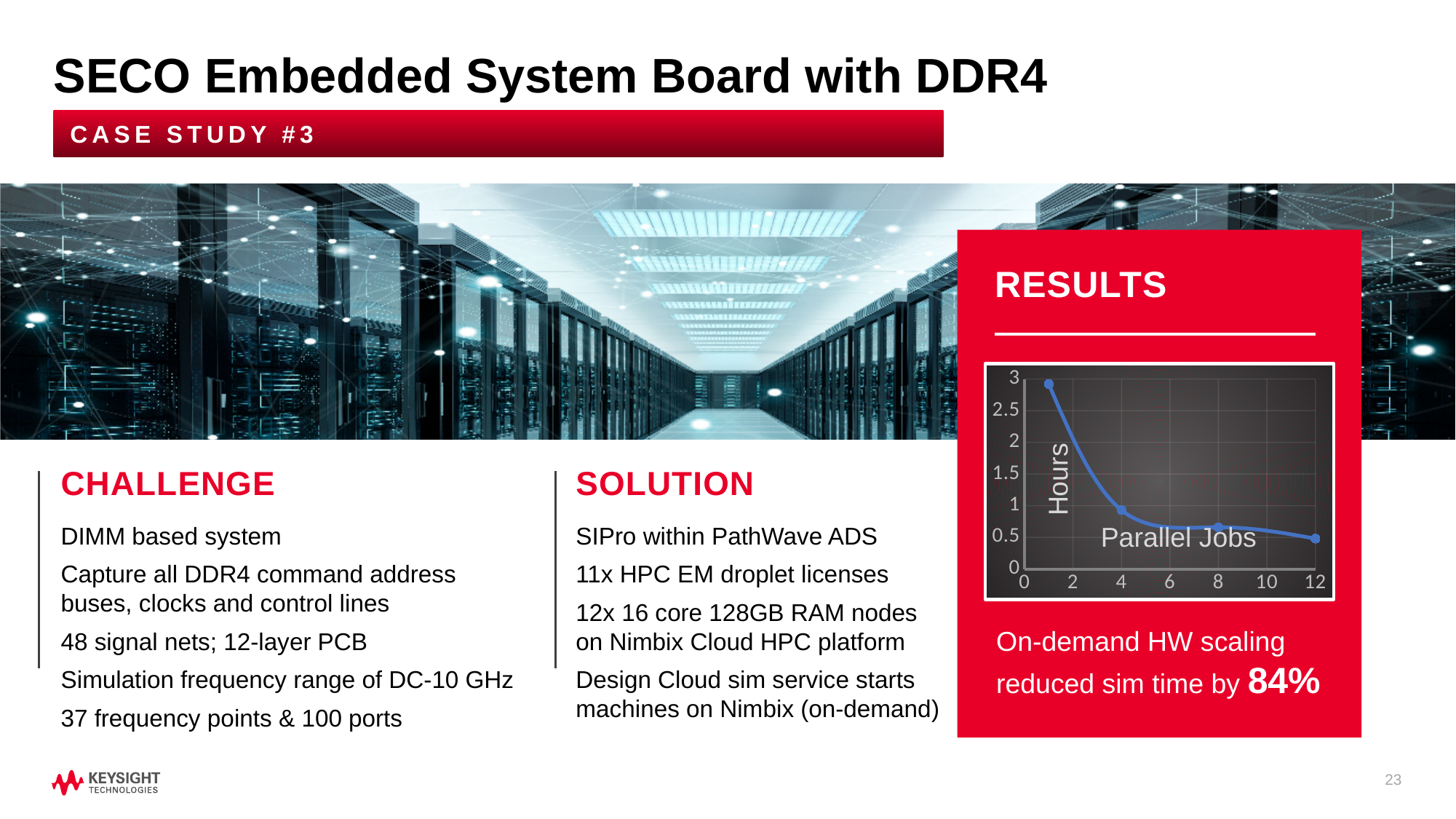
At which number of parallel jobs is the hours value lowest? 12 What kind of chart is shown in the RESULTS panel? line chart What is the label of the x axis of the chart? Parallel Jobs At which number of parallel jobs is the hours value highest? 1 Is the value in hours at 1 parallel job greater or less than 2.5? greater Is the value in hours at 12 parallel jobs greater or less than 1? less What is the label of the y axis of the chart? Hours Is the value in hours at 4 parallel jobs greater or less than 1.5? less Do the hours rise or fall as the number of parallel jobs increases? fall How many data points are plotted on the line? 4 Which has more hours: 1 parallel job or 12 parallel jobs? 1 parallel job